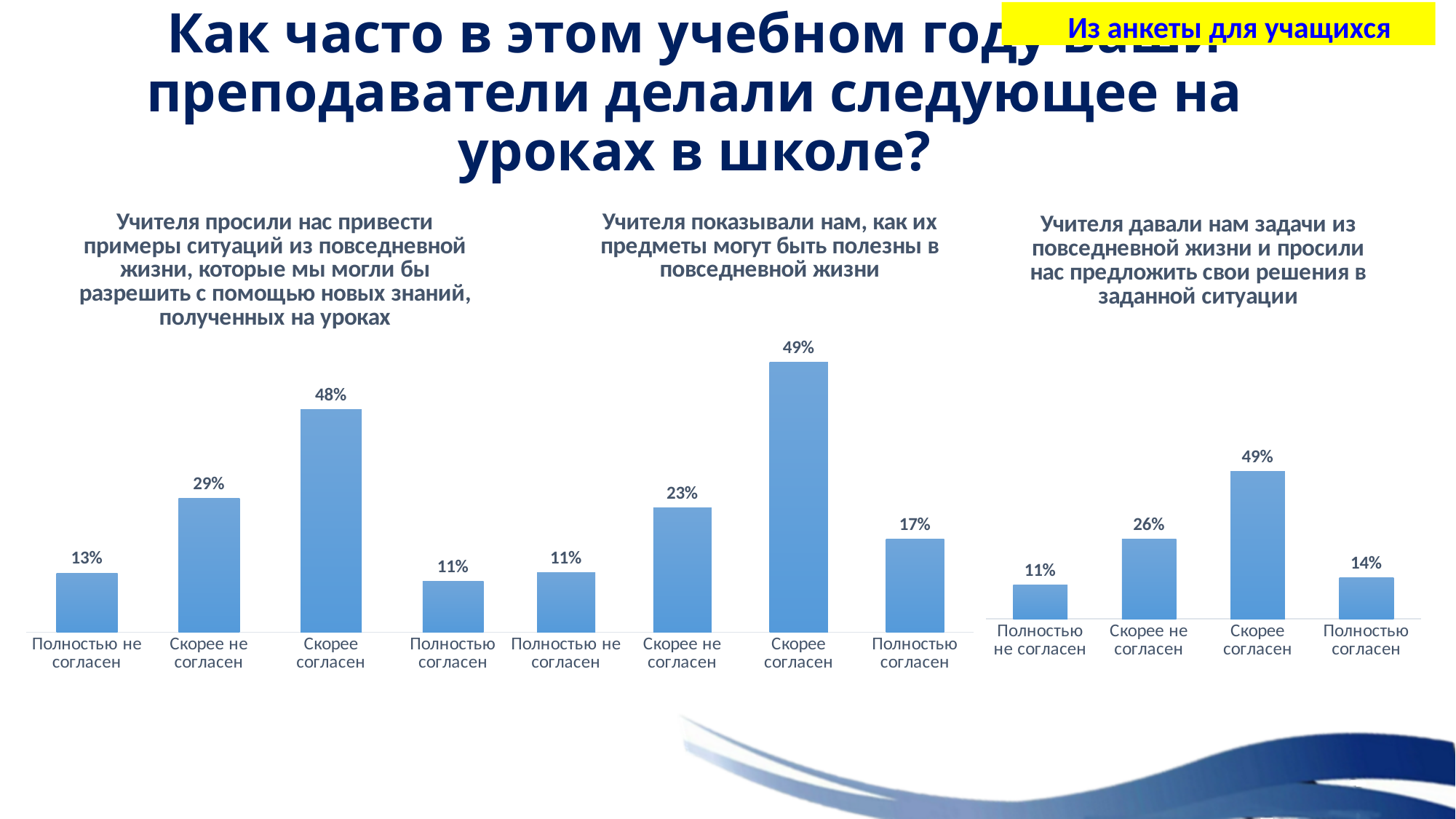
In the middle chart, what is the difference between "Скорее не согласен" and "Полностью не согласен"? 12% How many categories does the middle chart show? 4 In the middle chart ("Учителя показывали нам, как их предметы могут быть полезны в повседневной жизни"), what is the value for "Полностью согласен"? 17% What type of chart is the right chart? Bar chart In the left chart, which category has the lowest value? Полностью согласен In the left chart, what is the difference between "Скорее согласен" and "Скорее не согласен"? 19% In the right chart, which category has the lowest value? Полностью не согласен In the left chart ("Учителя просили нас привести примеры ситуаций из повседневной жизни..."), what is the value for "Скорее согласен"? 48% How many charts are shown on the slide? 3 In the middle chart, which category has the highest value? Скорее согласен In the right chart, which is larger: "Полностью согласен" or "Полностью не согласен"? Полностью согласен In the right chart ("Учителя давали нам задачи из повседневной жизни..."), what is the value for "Скорее не согласен"? 26%